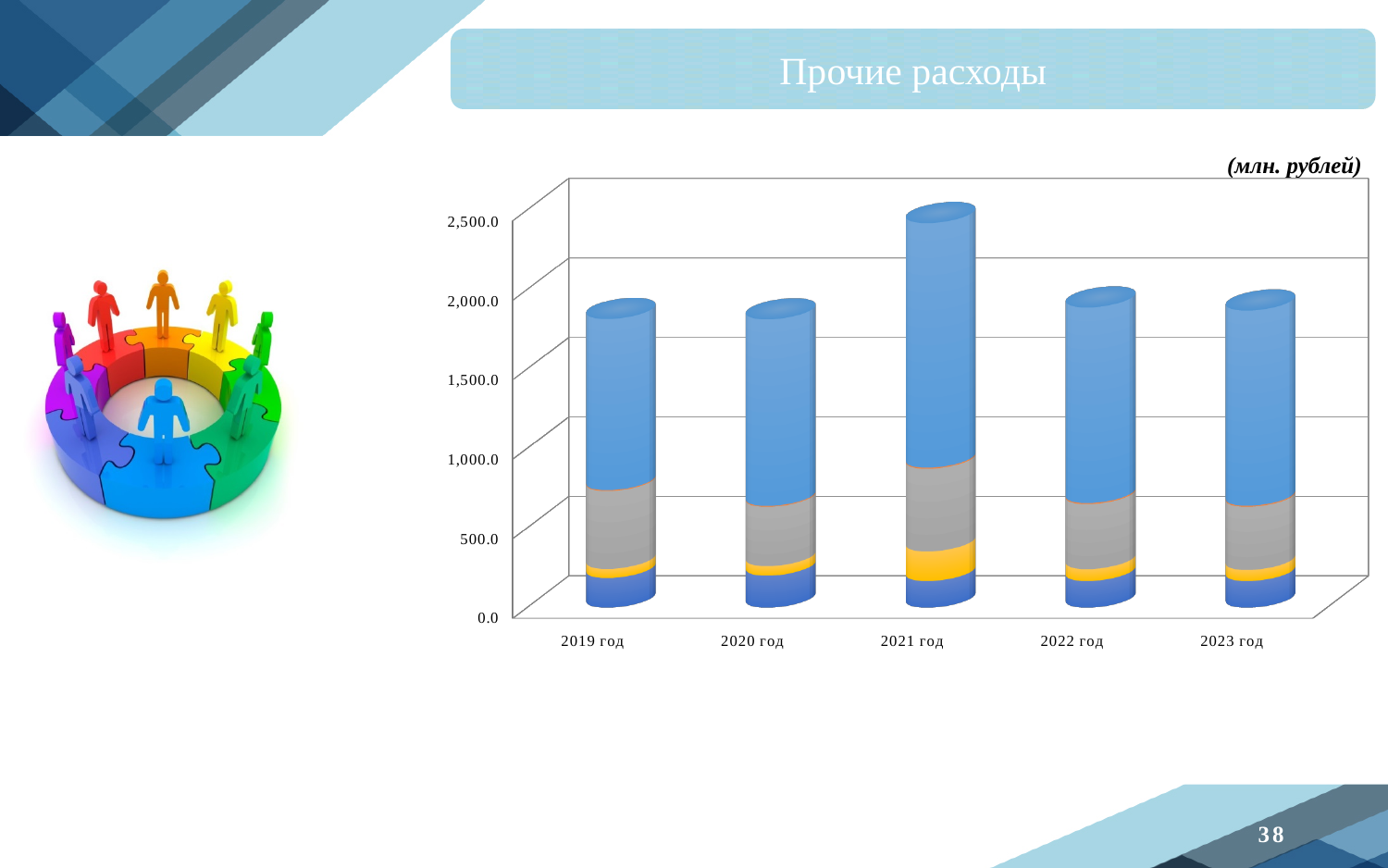
How many categories (years) are shown on the x axis of the chart? 5 In what units are the chart values given, according to the label above the chart? млн. рублей Is the total value for 2019 год greater or less than 2,000.0? less Is the total value for 2023 год greater or less than 1,500.0? greater Is the total value for 2020 год greater or less than 1,500.0? greater What kind of chart is shown on the slide? bar chart What is the title of the slide containing the chart? Прочие расходы Which is larger, the total bar for 2021 год or the total bar for 2020 год? 2021 год Which year has the highest total bar in the chart? 2021 год Which is larger, the total bar for 2021 год or the total bar for 2023 год? 2021 год